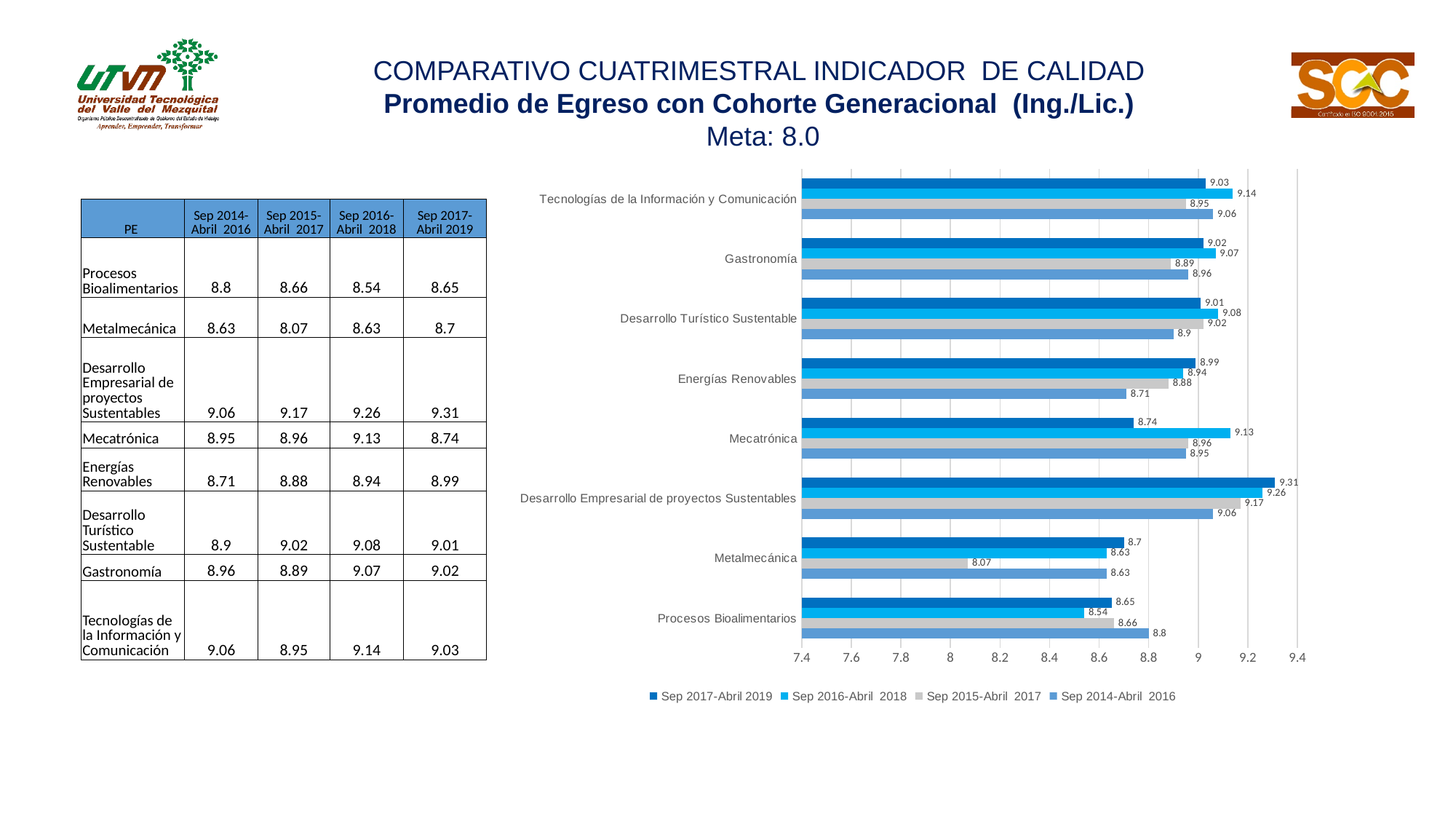
What kind of chart is shown on the slide? bar chart Which category has the lowest value in the Sep 2015-Abril 2017 series? Metalmecánica For Energías Renovables, do the values rise or fall from Sep 2014-Abril 2016 through Sep 2017-Abril 2019? rise How many categories (programs) are shown on the chart? 8 Which category has the highest value in the Sep 2017-Abril 2019 series? Desarrollo Empresarial de proyectos Sustentables What is the value for Metalmecánica in the Sep 2015-Abril 2017 series? 8.07 What is the maximum value shown on the chart's horizontal axis? 9.4 For Mecatrónica, what is the difference between the Sep 2016-Abril 2018 value and the Sep 2017-Abril 2019 value? 0.39 In the Sep 2016-Abril 2018 series, which is larger: Gastronomía or Tecnologías de la Información y Comunicación? Tecnologías de la Información y Comunicación How many series does the legend list? 4 What is the value for Desarrollo Empresarial de proyectos Sustentables in the Sep 2017-Abril 2019 series? 9.31 Is the Sep 2015-Abril 2017 value for Metalmecánica greater or less than 8.2? less